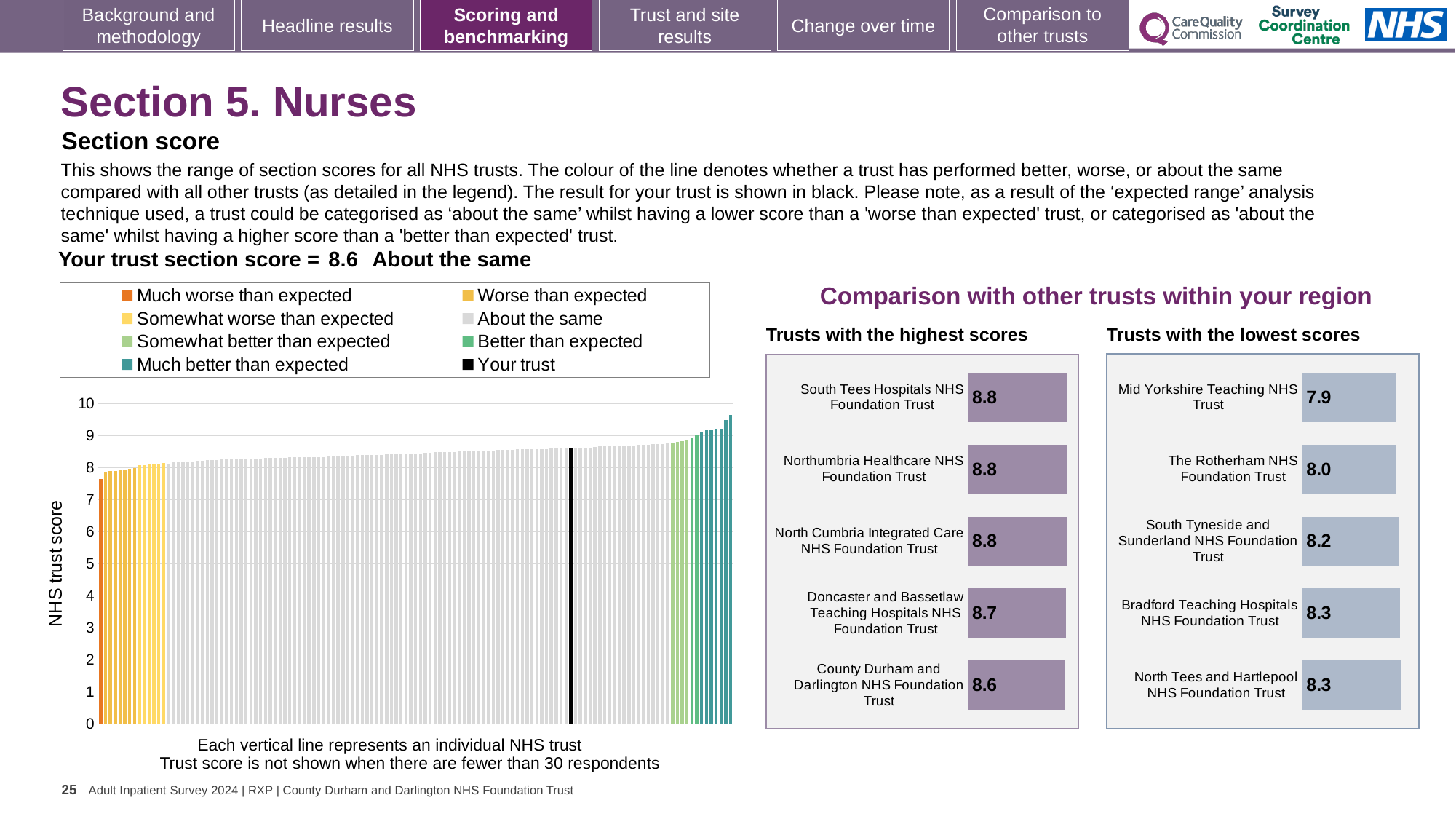
In the 'Trusts with the highest scores' chart, which trust has the lowest score shown? County Durham and Darlington NHS Foundation Trust In the 'Trusts with the lowest scores' chart, which trust has the lowest score? Mid Yorkshire Teaching NHS Trust In the 'Trusts with the lowest scores' chart, how much higher is Bradford Teaching Hospitals NHS Foundation Trust's score than Mid Yorkshire Teaching NHS Trust's score? 0.4 In the large 'NHS trust score' chart, is the value of the leftmost (orange) bar greater or less than 8? less In the 'Trusts with the lowest scores' chart, what is the score for South Tyneside and Sunderland NHS Foundation Trust? 8.2 In the 'Trusts with the lowest scores' chart, what is the score for Mid Yorkshire Teaching NHS Trust? 7.9 In the 'Trusts with the lowest scores' chart, which has the higher score: The Rotherham NHS Foundation Trust or South Tyneside and Sunderland NHS Foundation Trust? South Tyneside and Sunderland NHS Foundation Trust In the 'Trusts with the highest scores' chart, what is the difference between the scores of South Tees Hospitals NHS Foundation Trust and County Durham and Darlington NHS Foundation Trust? 0.2 How many entries does the legend of the large 'NHS trust score' chart list? 8 How many trusts are listed in the 'Trusts with the highest scores' chart? 5 In the 'Trusts with the highest scores' chart, what is the score for Doncaster and Bassetlaw Teaching Hospitals NHS Foundation Trust? 8.7 What kind of chart is the large 'NHS trust score' chart on the left of the slide? Bar chart